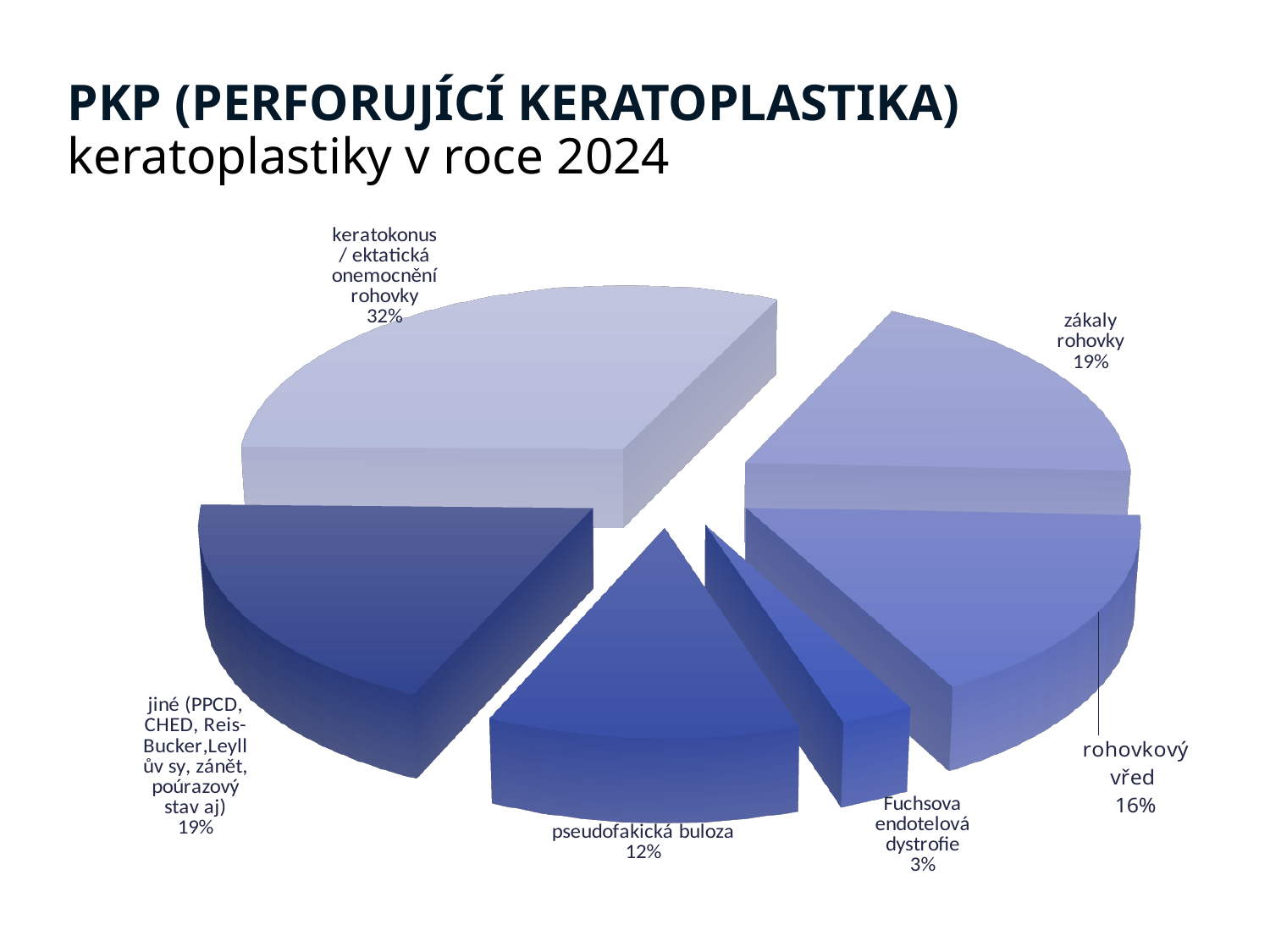
Which is larger, the share for pseudofakická buloza or the share for rohovkový vřed? rohovkový vřed What share of the pie is labelled for keratokonus / ektatická onemocnění rohovky? 32% How many slices does the pie chart have? 6 What percentage is shown for zákaly rohovky? 19% Which category has the largest share of the pie? keratokonus / ektatická onemocnění rohovky What percentage is shown for Fuchsova endotelová dystrofie? 3% What kind of chart is shown on the slide? pie chart Which category has the smallest share of the pie? Fuchsova endotelová dystrofie What is the difference in percentage points between keratokonus / ektatická onemocnění rohovky and rohovkový vřed? 16 What year does the chart title say the keratoplasties are from? 2024 What percentage is shown for rohovkový vřed? 16% What percentage is shown for pseudofakická buloza? 12%